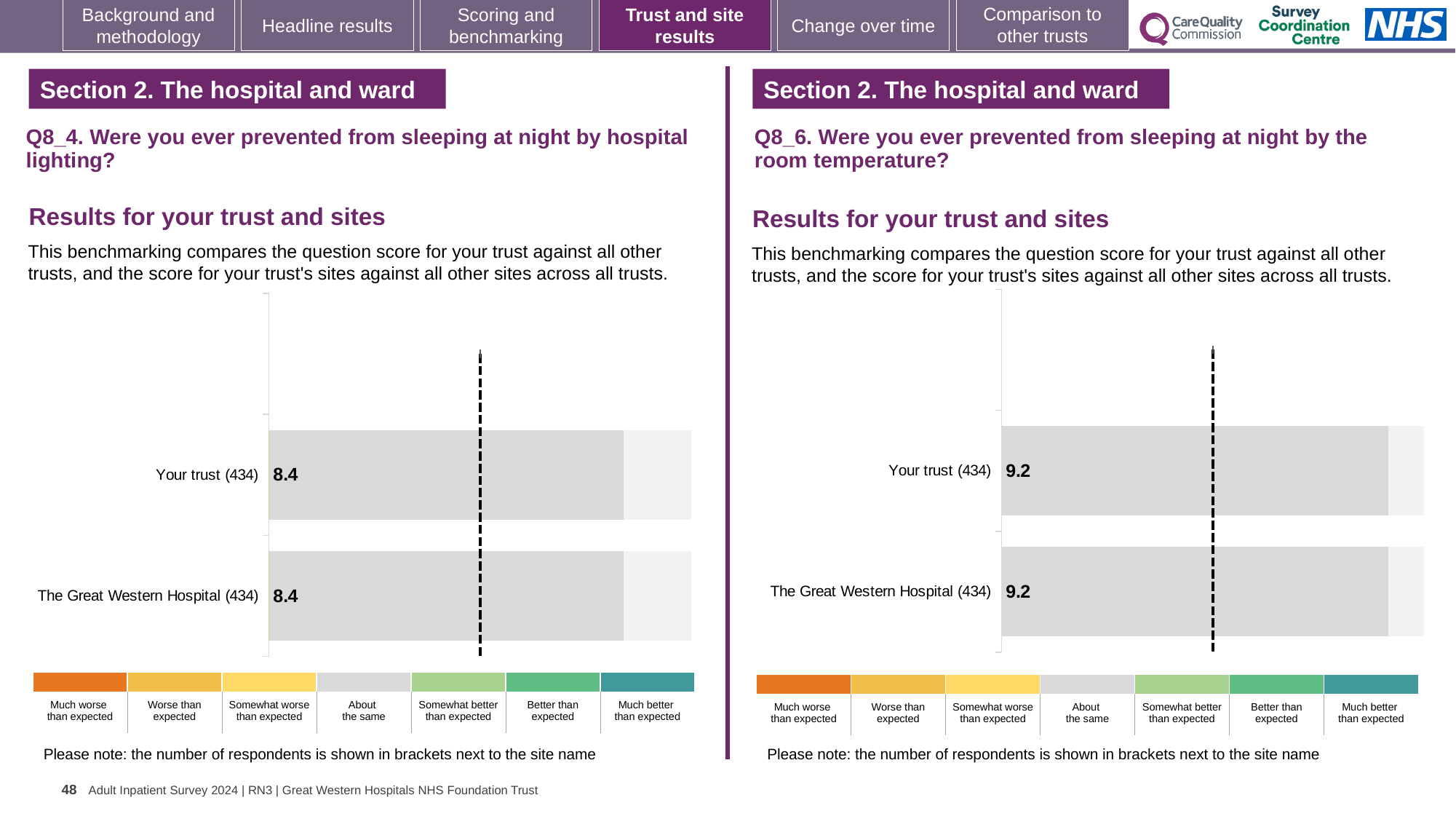
How many bars are plotted on the right chart (Q8_6, room temperature)? 2 On the right chart (Q8_6, room temperature), what is the score for Your trust (434)? 9.2 What is the question text shown above the right chart? Q8_6. Were you ever prevented from sleeping at night by the room temperature? On the left chart (Q8_4, hospital lighting), what is the score for The Great Western Hospital (434)? 8.4 Is the score for Your trust on the right chart (Q8_6, room temperature) larger or smaller than the score for Your trust on the left chart (Q8_4, hospital lighting)? Larger How many respondents are shown in brackets next to Your trust on the left chart (Q8_4, hospital lighting)? 434 On the right chart (Q8_6, room temperature), what is the score for The Great Western Hospital (434)? 9.2 On the right chart (Q8_6, room temperature), what is the difference between the score for Your trust and the score for The Great Western Hospital? 0.0 What kind of chart is used on the left (Q8_4, hospital lighting)? Bar chart How many bars are plotted on the left chart (Q8_4, hospital lighting)? 2 On the left chart (Q8_4, hospital lighting), what is the difference between the score for Your trust and the score for The Great Western Hospital? 0.0 On the left chart (Q8_4, hospital lighting), what is the score for Your trust (434)? 8.4